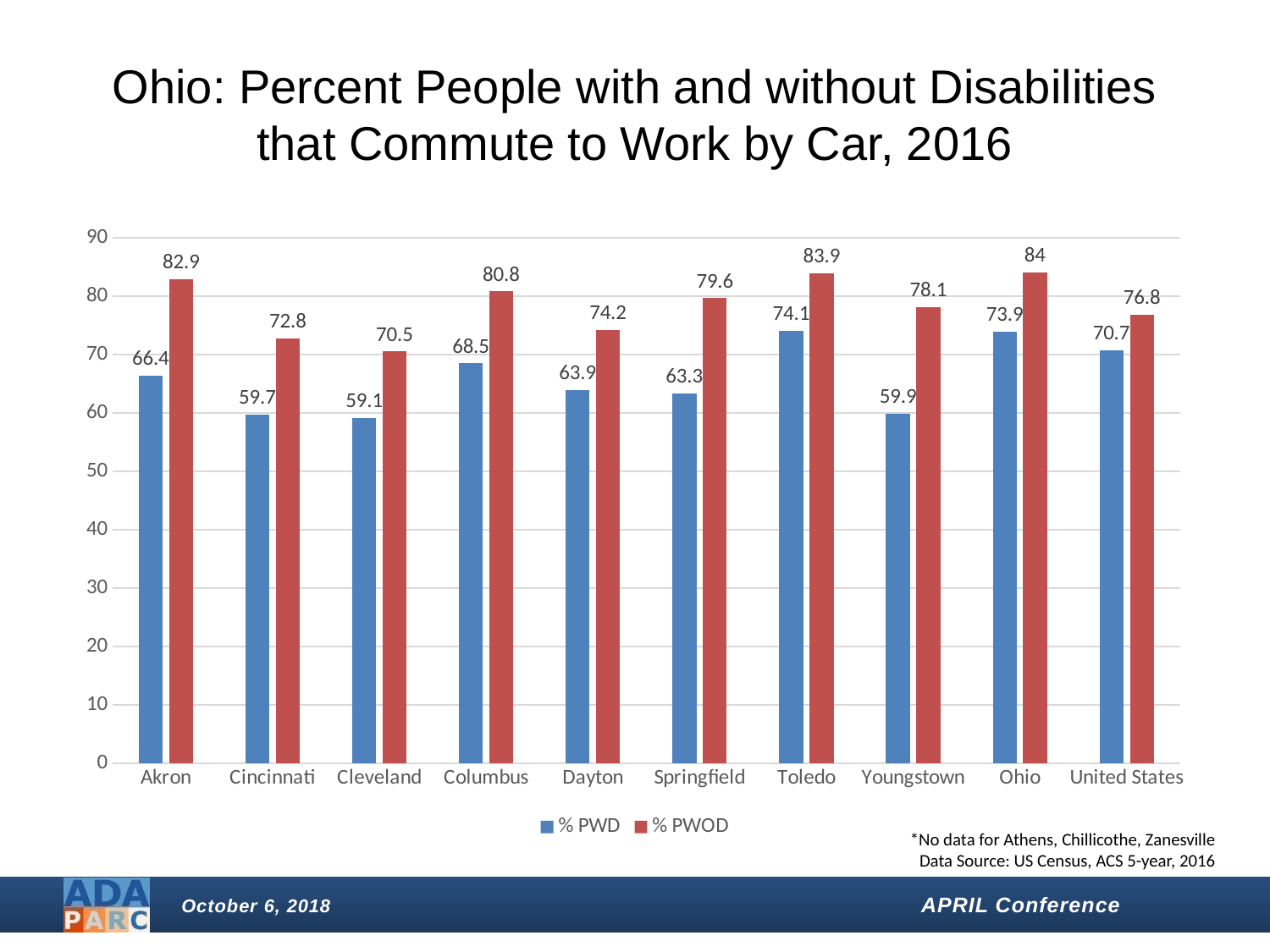
What is the difference between the % PWOD and % PWD values for Akron? 16.5 What kind of chart is shown on the slide? Bar chart What is the % PWOD value for Springfield? 79.6 How many categories are shown on the x axis? 10 How many series does the legend list? 2 Is the % PWOD value for Cincinnati greater or less than 70? greater Which colour represents the % PWOD series? Red What is the % PWD value for Akron? 66.4 What is the % PWD value for the United States? 70.7 What is the difference between the % PWOD and % PWD values for Youngstown? 18.2 Which has a higher % PWD value, Columbus or Dayton? Columbus Which category has the lowest % PWOD value? Cleveland